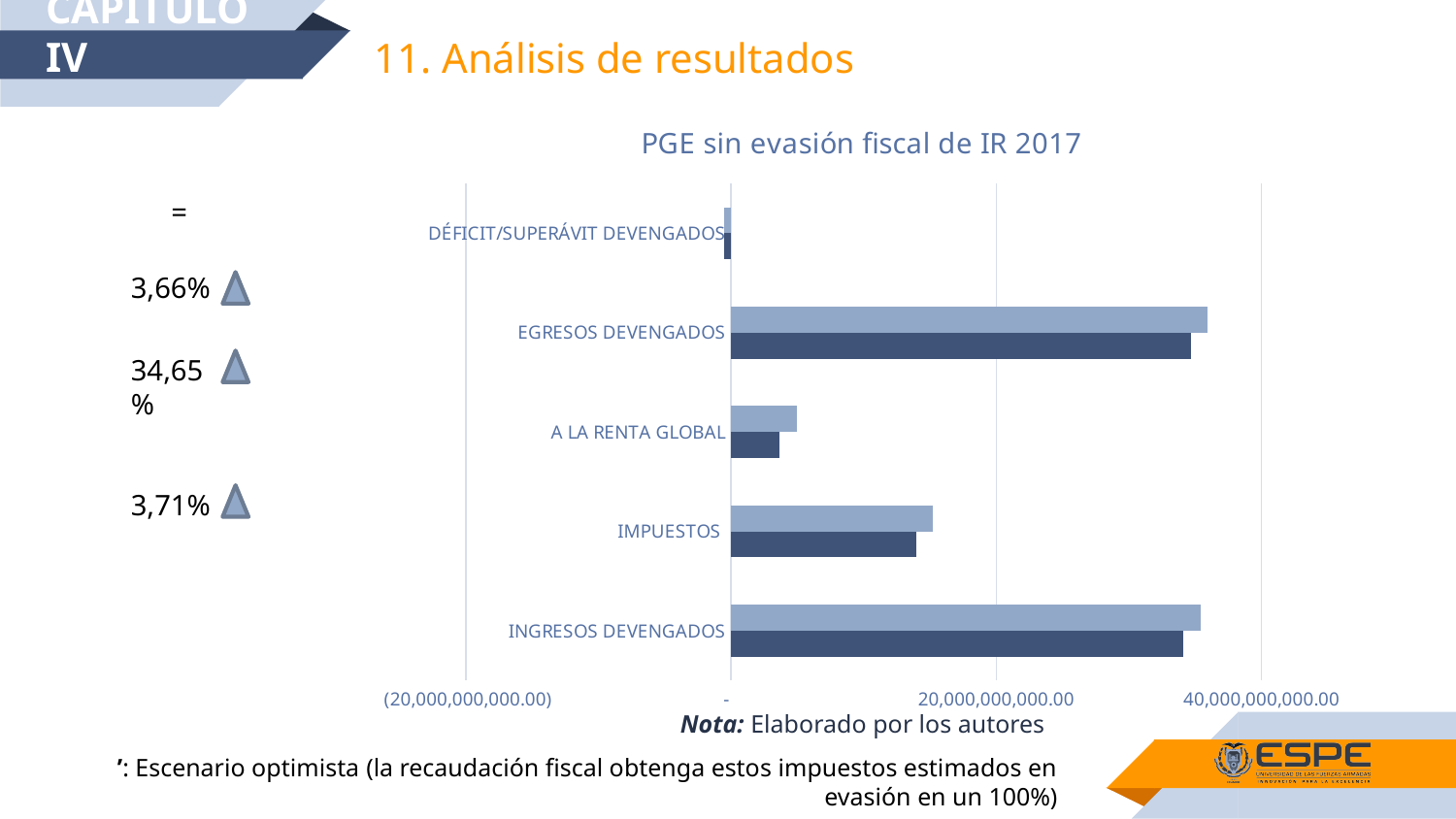
Which category has the smallest values in the chart? DÉFICIT/SUPERÁVIT DEVENGADOS How many bars are plotted for each category in the chart? 2 Is the light blue value for EGRESOS DEVENGADOS greater or less than 20,000,000,000.00? greater Is the light blue value for EGRESOS DEVENGADOS greater or less than 40,000,000,000.00? less What kind of chart is shown on the slide? Bar chart Which has the larger dark blue value, EGRESOS DEVENGADOS or A LA RENTA GLOBAL? EGRESOS DEVENGADOS Which has the larger light blue value, IMPUESTOS or A LA RENTA GLOBAL? IMPUESTOS Is the dark blue value for INGRESOS DEVENGADOS greater or less than 20,000,000,000.00? greater How many categories are shown on the chart's vertical axis? 5 What is the title of the chart? PGE sin evasión fiscal de IR 2017